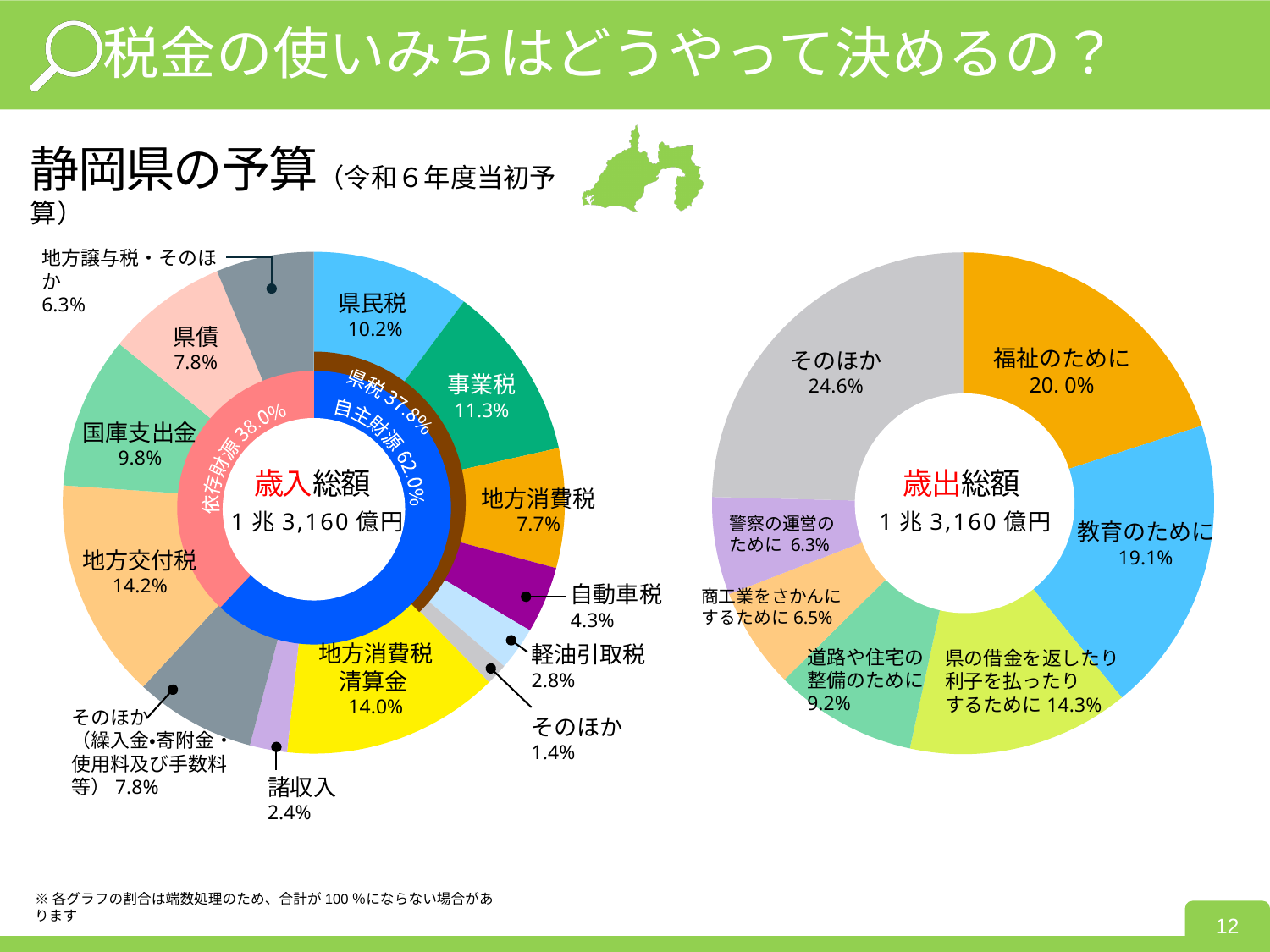
What type of chart is used for 歳出総額 on the right? Donut (pie) chart In the 歳出総額 chart on the right, what is the difference between 福祉のために and 教育のために? 0.9% In the 歳入総額 chart on the left, which category has the smallest share? そのほか (1.4%) What total amount is shown in the centre of the 歳入総額 chart on the left? 1兆3,160億円 In the 歳入総額 chart on the left, which is larger, 国庫支出金 or 県債? 国庫支出金 In the 歳出総額 chart on the right, which labelled category has the largest share? そのほか (24.6%) In the 歳入総額 chart on the left, what percentage is shown for 地方交付税? 14.2% In the 歳出総額 chart on the right, which category has the smallest share? 警察の運営のために (6.3%) In the 歳入総額 chart on the left, what is the difference between 事業税 and 県民税? 1.1% How many categories are shown in the 歳出総額 chart on the right? 7 In the 歳出総額 chart on the right, what percentage is shown for 教育のために? 19.1% In the 歳入総額 chart on the left, what percentage is shown for 県民税? 10.2%